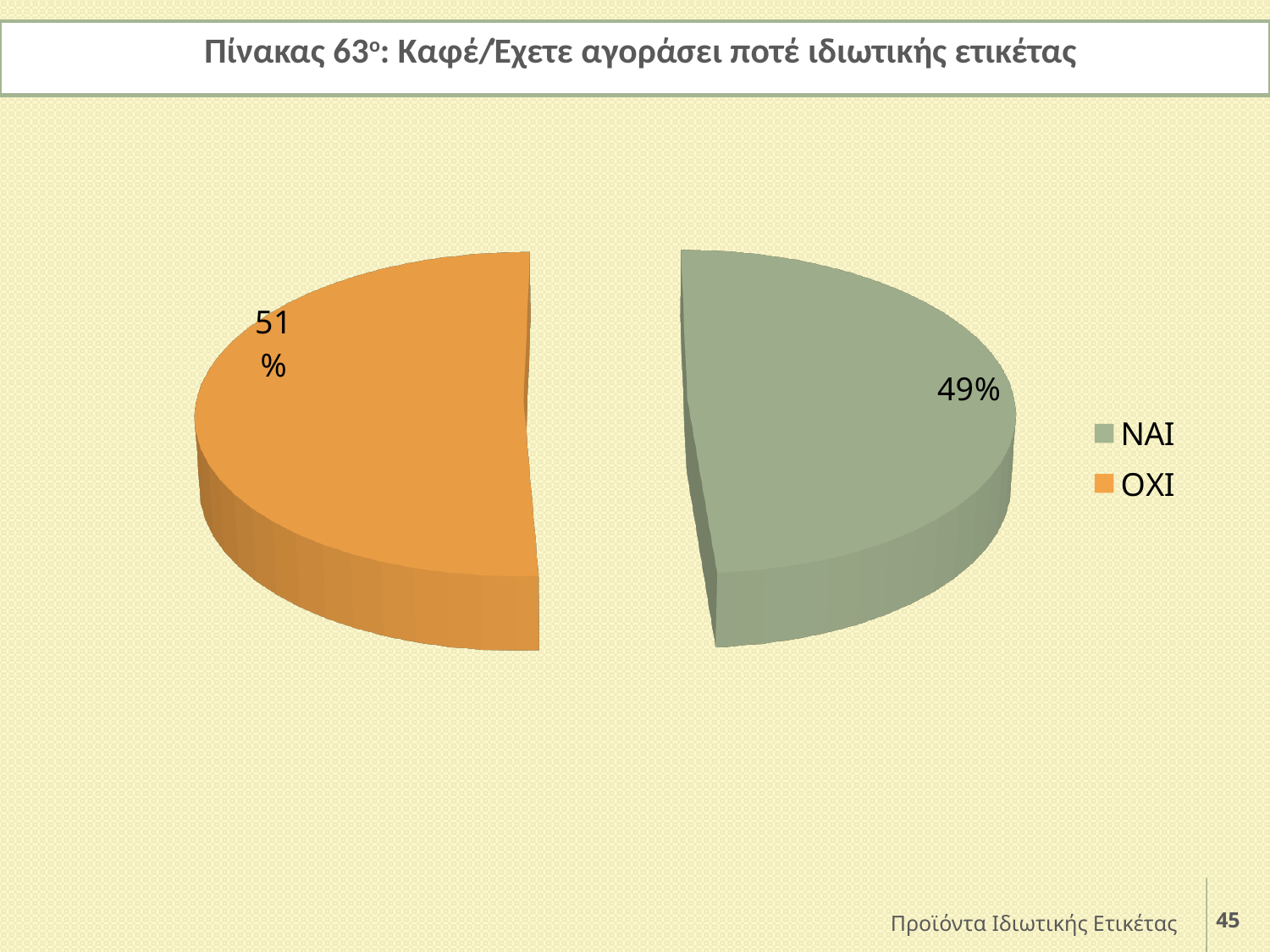
What is the difference in percentage points between the ΟΧΙ and ΝΑΙ slices? 2 What share of the pie does the ΝΑΙ slice represent? 49% What colour is the ΟΧΙ slice? orange How many slices does the pie chart have? 2 Which slice is the largest in the pie chart? ΟΧΙ Which slice is the smallest in the pie chart? ΝΑΙ What kind of chart is shown on the slide? pie chart What is the title of the chart on the slide? Πίνακας 63ο: Καφέ/Εχετε αγοράσει ποτέ ιδιωτικής ετικέτας What share of the pie does the ΟΧΙ slice represent? 51% Which is larger, the ΝΑΙ slice or the ΟΧΙ slice? ΟΧΙ How many entries does the legend list? 2